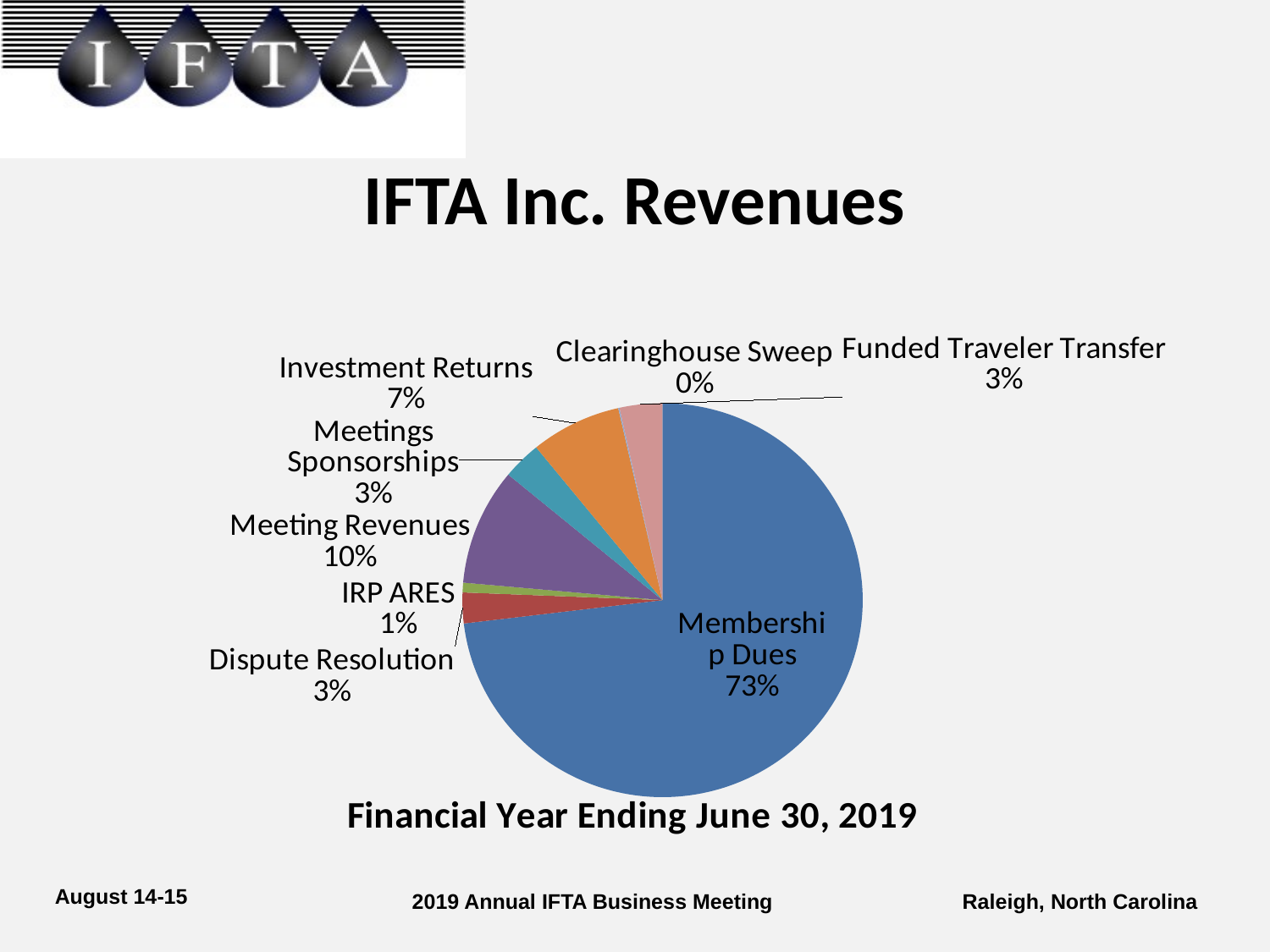
Which revenue category has the smallest share of the pie? Clearinghouse Sweep What kind of chart is shown on the slide? Pie chart Which is larger, the share for Investment Returns or the share for Meeting Revenues? Meeting Revenues How many percentage points larger is the Membership Dues share than the Meeting Revenues share? 63 What share of revenues comes from Meeting Revenues? 10% What share of revenues comes from Investment Returns? 7% What is the title printed below the pie chart? Financial Year Ending June 30, 2019 What share of revenues comes from Clearinghouse Sweep? 0% How many categories are shown in the pie chart? 8 Which revenue category has the largest share of the pie? Membership Dues